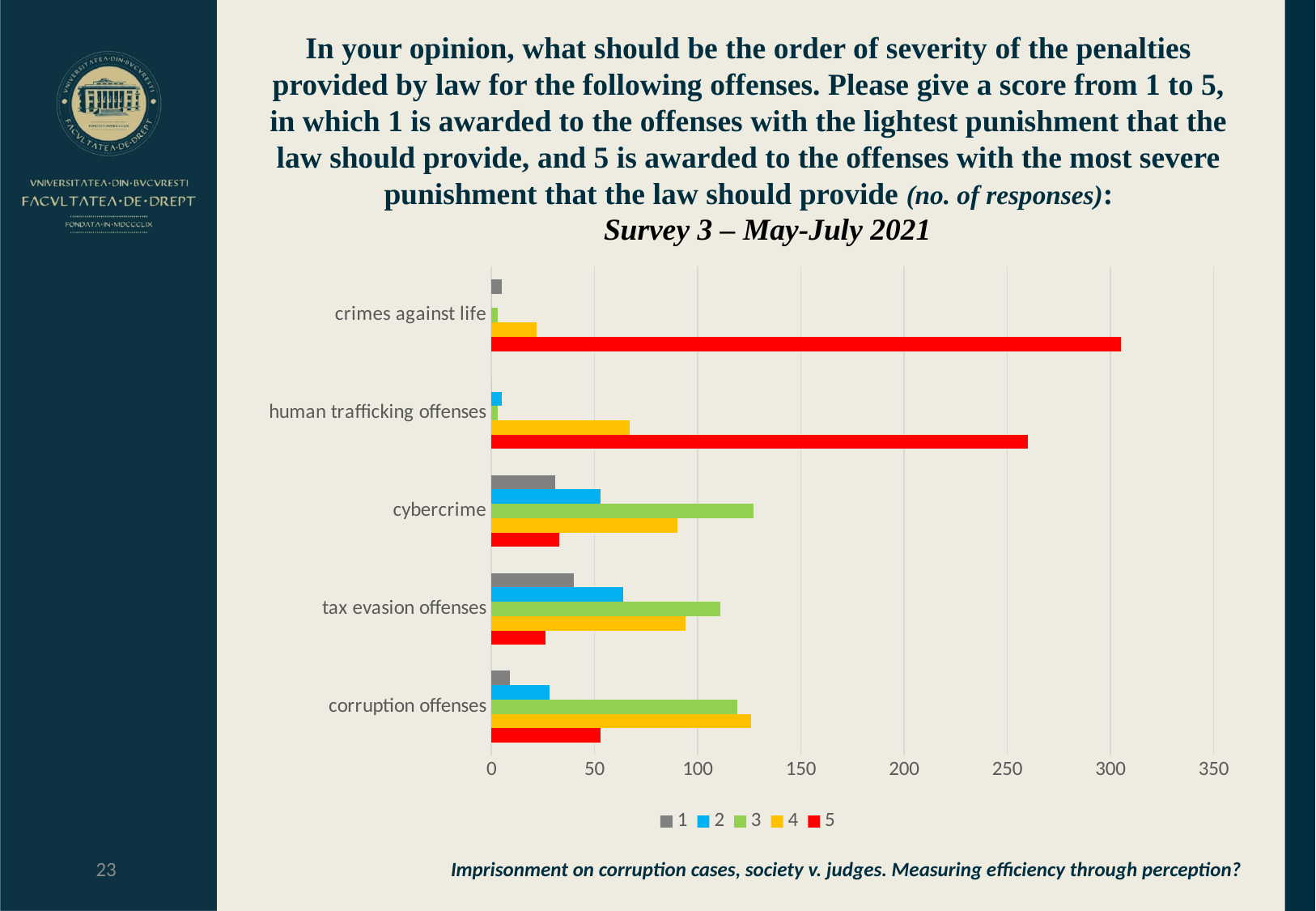
What colour represents score 5 in the legend? red Is the score 5 value for crimes against life greater or less than 250? greater For cybercrime, which is larger: the score 3 value or the score 4 value? score 3 Is the score 3 value for cybercrime greater or less than 100? greater For corruption offenses, which is larger: the score 3 value or the score 5 value? score 3 Is the score 5 value for corruption offenses greater or less than 100? less How many offense categories are plotted on the chart? 5 Which offense category has the shortest bar for score 5? tax evasion offenses Which offense category has the longest bar for score 5? crimes against life How many series does the legend list? 5 What kind of chart is shown on the slide? bar chart